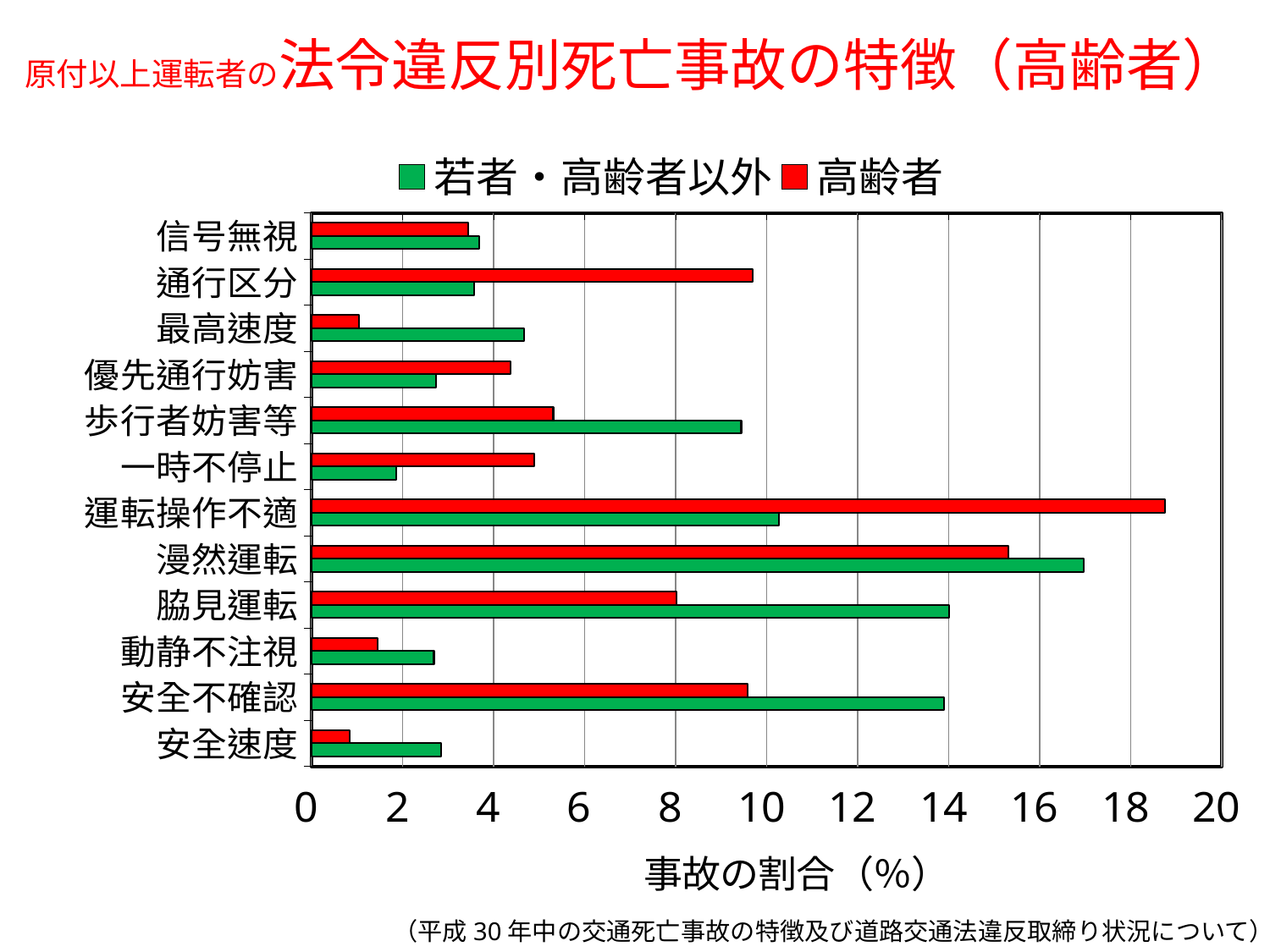
For 通行区分, which series has the larger value, 高齢者 or 若者・高齢者以外? 高齢者 Which category has the lowest value for 若者・高齢者以外? 一時不停止 Is the 高齢者 value for 運転操作不適 greater or less than 18? greater Which category has the highest value for 若者・高齢者以外? 漫然運転 What is the x-axis title of the chart? 事故の割合（%） How many violation categories are plotted on the y axis? 12 How many series does the legend list? 2 Is the 高齢者 value for 脇見運転 greater or less than 10? less What kind of chart is shown on the slide? bar chart Which category has the highest value for 高齢者? 運転操作不適 Which colour represents the 高齢者 series in the chart? red For 歩行者妨害等, which series has the larger value, 高齢者 or 若者・高齢者以外? 若者・高齢者以外